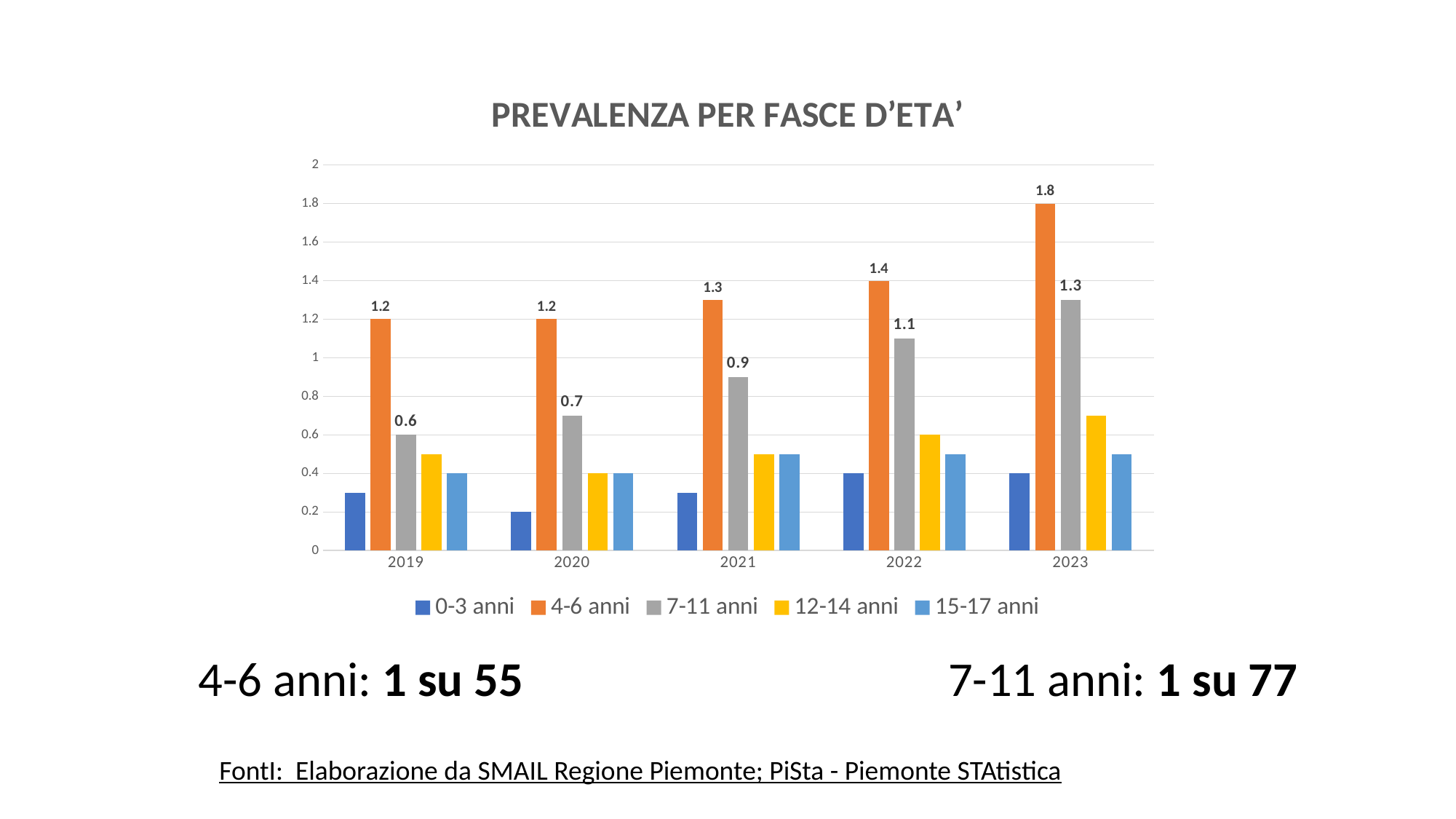
In which year is the 4-6 anni series highest? 2023 What is the difference between the 4-6 anni value in 2023 and in 2019? 0.6 How many years are shown on the x axis? 5 What is the value for the 4-6 anni series in 2023? 1.8 In 2021, which is larger: the 4-6 anni value or the 7-11 anni value? 4-6 anni In 2022, what is the difference between the 4-6 anni value and the 7-11 anni value? 0.3 What is the value for the 7-11 anni series in 2021? 0.9 Does the 4-6 anni series rise or fall from 2019 to 2023? rise What is the value for the 7-11 anni series in 2019? 0.6 How many series does the legend list? 5 Is the value for 0-3 anni in 2019 greater or less than 0.4? less In which year is the 7-11 anni series lowest? 2019